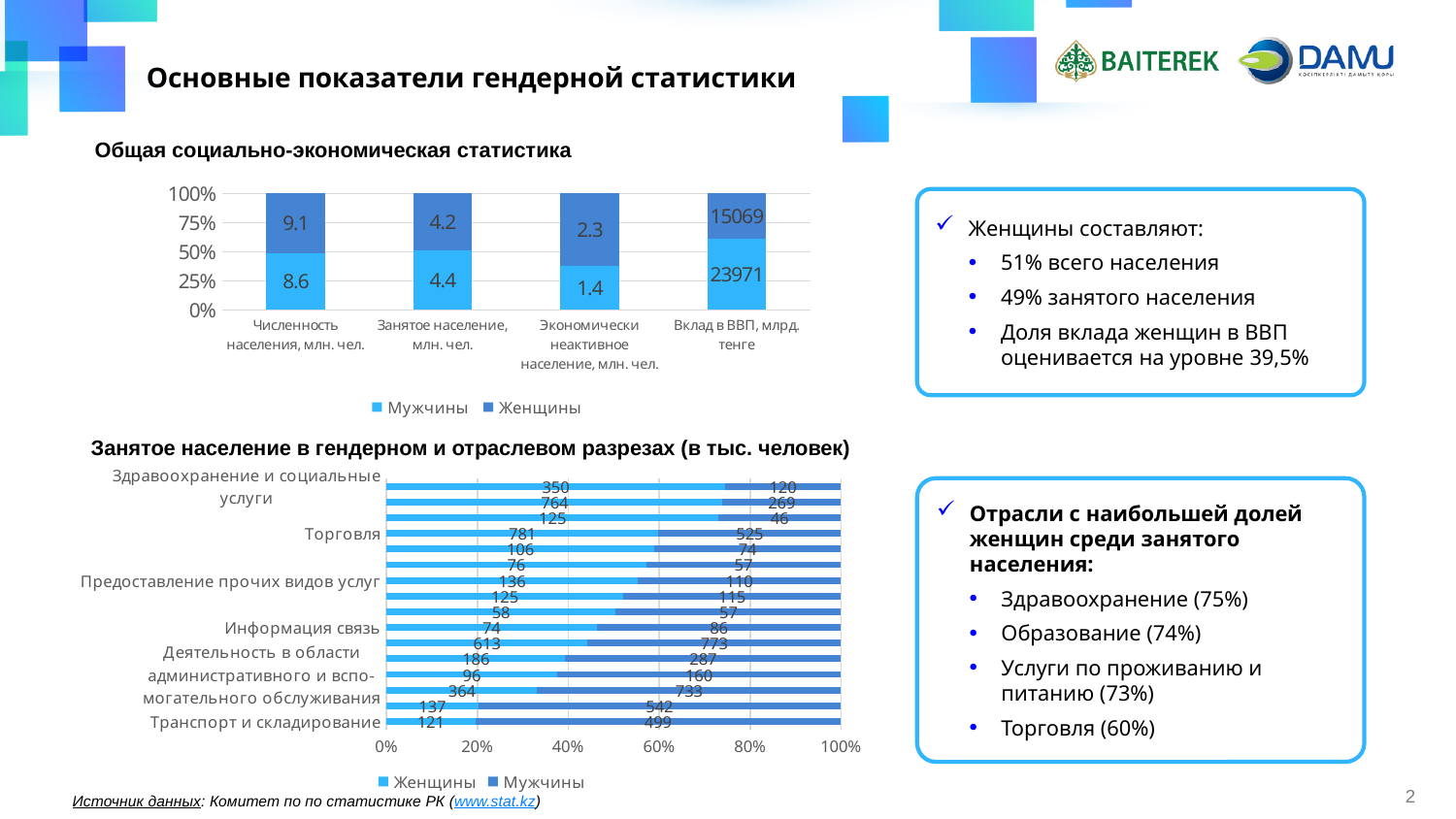
In the bottom chart 'Занятое население в гендерном и отраслевом разрезах', what is the value for Женщины in the category 'Торговля'? 781 In the top chart 'Общая социально-экономическая статистика', what is the value for Мужчины in the category 'Численность населения, млн. чел.'? 8.6 In the top chart 'Общая социально-экономическая статистика', what is the value for Мужчины in the category 'Вклад в ВВП, млрд. тенге'? 23971 In the top chart 'Общая социально-экономическая статистика', how many categories are shown on the x axis? 4 In the top chart 'Общая социально-экономическая статистика', what is the difference between the Мужчины and Женщины values for 'Вклад в ВВП, млрд. тенге'? 8902 In the top chart 'Общая социально-экономическая статистика', which is larger for 'Занятое население, млн. чел.': Мужчины or Женщины? Мужчины What type of chart is the top chart 'Общая социально-экономическая статистика'? Stacked bar chart In the bottom chart 'Занятое население в гендерном и отраслевом разрезах', which series is shown in light blue according to the legend? Женщины In the top chart 'Общая социально-экономическая статистика', what is the value for Женщины in the category 'Экономически неактивное население, млн. чел.'? 2.3 In the bottom chart 'Занятое население в гендерном и отраслевом разрезах', what is the value for Мужчины in the category 'Транспорт и складирование'? 499 In the top chart 'Общая социально-экономическая статистика', how many series does the legend list? 2 In the bottom chart 'Занятое население в гендерном и отраслевом разрезах', which is larger for 'Транспорт и складирование': Женщины or Мужчины? Мужчины